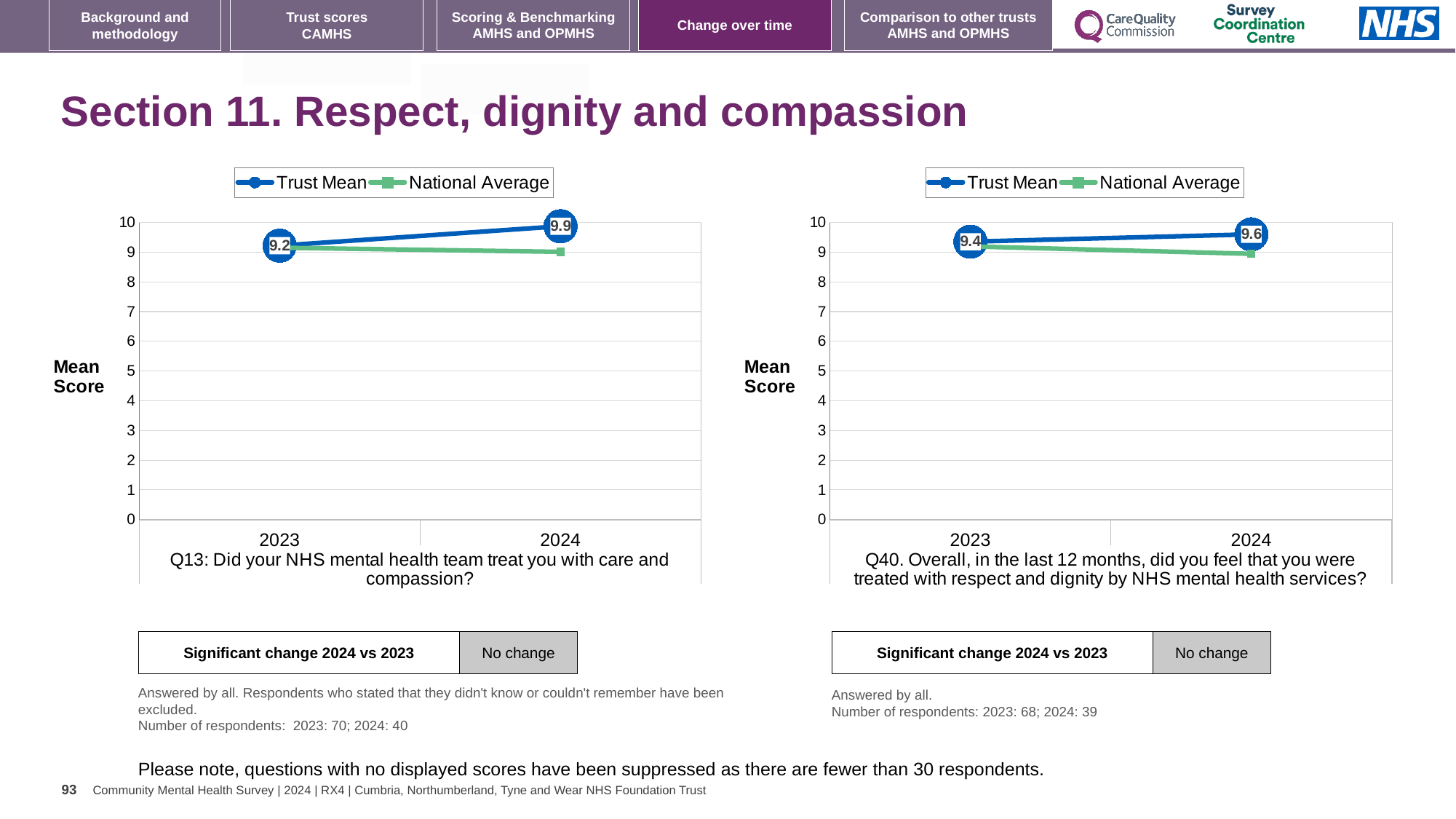
On the Q13 chart (left), what is the Trust Mean for 2024? 9.9 How many series does the legend of the Q40 chart (right) list? 2 On the Q13 chart (left), by how much did the Trust Mean change from 2023 to 2024? 0.7 On the Q40 chart (right), does the National Average rise or fall from 2023 to 2024? fall What type of chart is the Q13 chart on the left? line chart On the Q13 chart (left), is the National Average for 2024 greater or less than 8? greater On the Q40 chart (right), which series has the higher value in 2024, Trust Mean or National Average? Trust Mean On the Q40 chart (right), what is the difference between the Trust Mean in 2024 and in 2023? 0.2 On the Q13 chart (left), what is the Trust Mean for 2023? 9.2 On the Q13 chart (left), does the Trust Mean rise or fall from 2023 to 2024? rise On the Q40 chart (right), what is the Trust Mean for 2024? 9.6 On the Q40 chart (right), what is the Trust Mean for 2023? 9.4